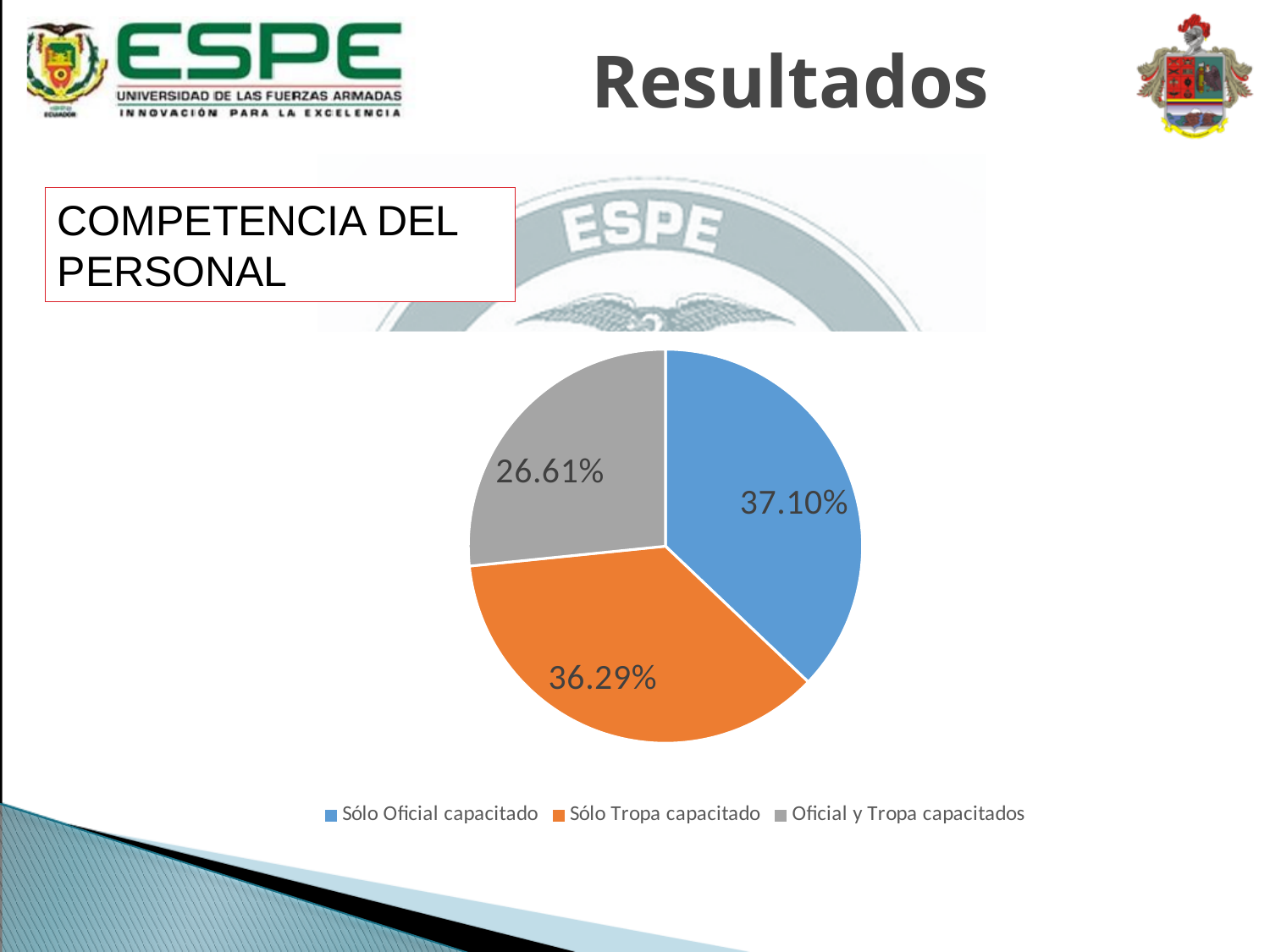
Which is larger, the slice for Sólo Oficial capacitado or the slice for Sólo Tropa capacitado? Sólo Oficial capacitado What percentage of the pie chart corresponds to Oficial y Tropa capacitados? 26.61% What kind of chart is shown on the slide? Pie chart What is the heading in the box above the chart? COMPETENCIA DEL PERSONAL Which category has the largest slice of the pie chart? Sólo Oficial capacitado What percentage of the pie chart corresponds to Sólo Tropa capacitado? 36.29% Which category has the smallest slice of the pie chart? Oficial y Tropa capacitados What percentage of the pie chart corresponds to Sólo Oficial capacitado? 37.10% What colour is the slice for Sólo Tropa capacitado? Orange How many slices does the pie chart have? 3 What is the difference in percentage points between Sólo Oficial capacitado and Oficial y Tropa capacitados? 10.49 What is the difference in percentage points between Sólo Tropa capacitado and Oficial y Tropa capacitados? 9.68